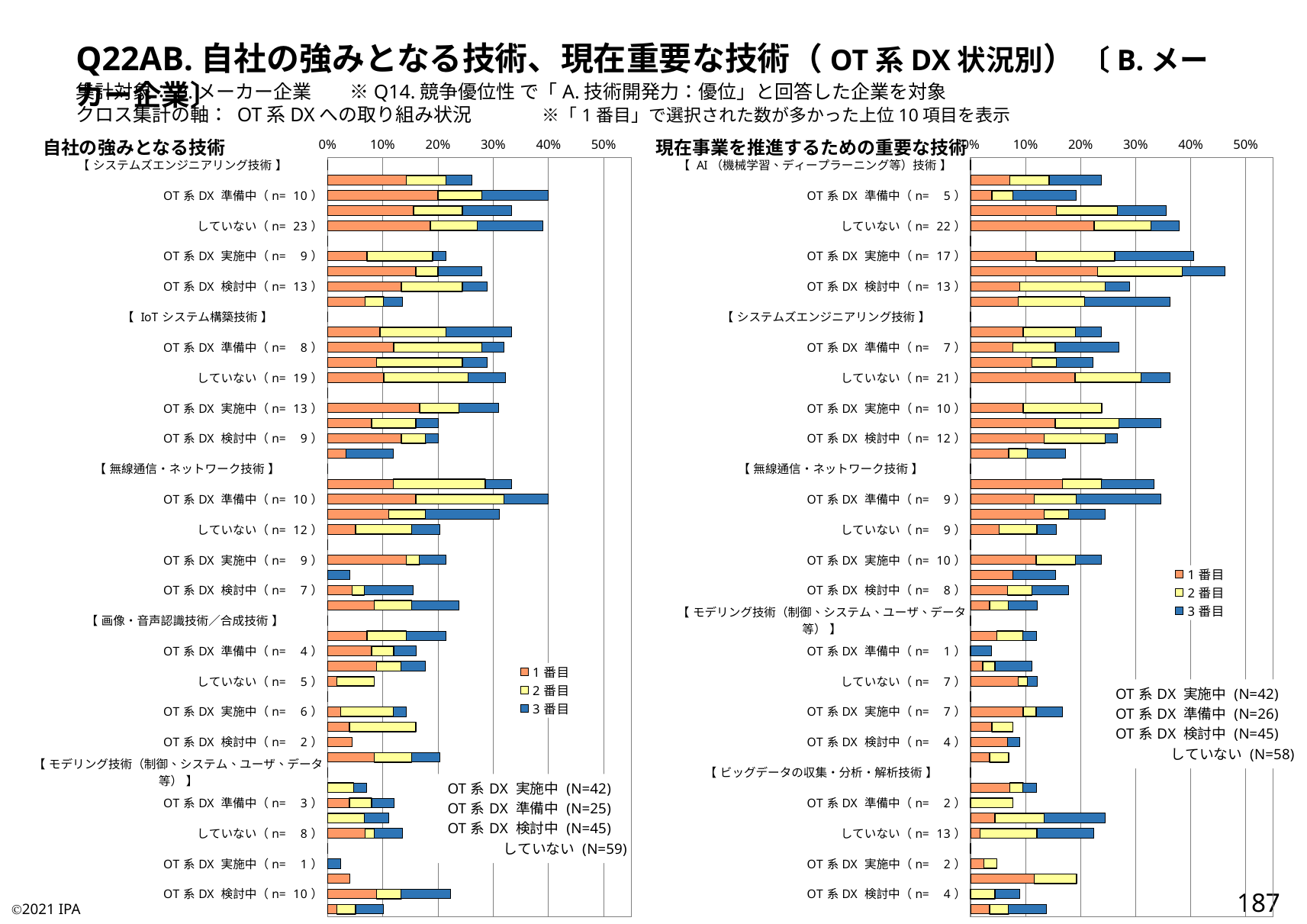
In the right chart (現在事業を推進するための重要な技術), is the total bar for していない (n=22) under AI技術 greater or less than 30%? greater In the left chart (自社の強みとなる技術), is the total bar for していない (n=23) under システムズエンジニアリング技術 greater or less than 30%? greater How many series does the legend of the left chart (自社の強みとなる技術) list? 3 In the left chart (自社の強みとなる技術), is the total bar for OT系DX 実施中 (n=1) under モデリング技術 greater or less than 10%? less How many series does the legend of the right chart (現在事業を推進するための重要な技術) list? 3 What kind of chart is the left chart titled 自社の強みとなる技術? Stacked bar chart In the left chart (自社の強みとなる技術), what are the three legend entries? 1番目, 2番目, 3番目 What kind of chart is the right chart titled 現在事業を推進するための重要な技術? Stacked bar chart In the right chart (現在事業を推進するための重要な技術), what is the highest value shown on the percentage axis? 50%